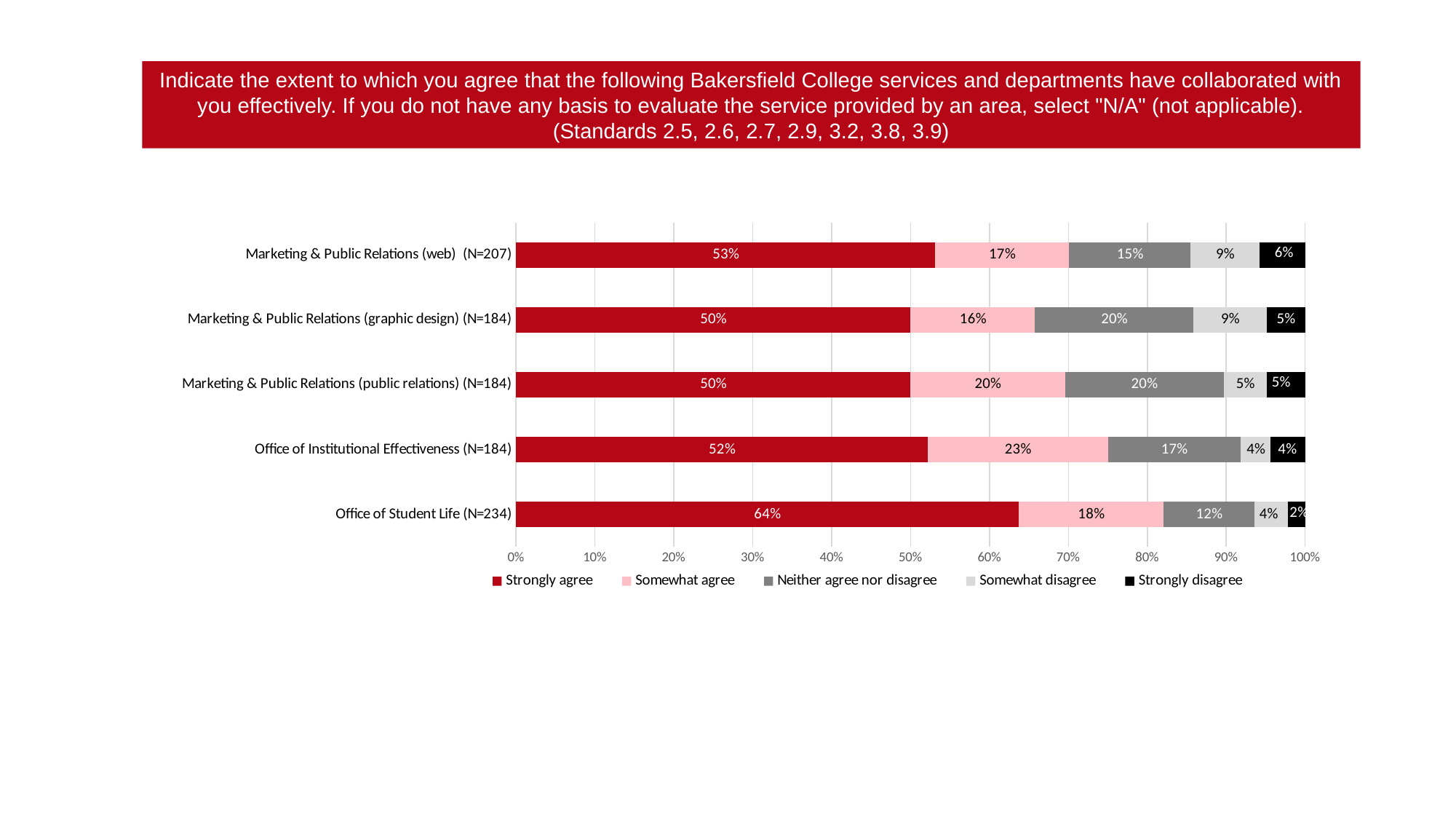
What kind of chart is shown on the slide? Stacked bar chart How many categories (services/departments) are shown on the chart? 5 What is the Strongly disagree value for Marketing & Public Relations (web) (N=207)? 6% How many series does the legend list? 5 Which category has the highest Strongly agree percentage? Office of Student Life (N=234) Which category has the lowest Strongly disagree percentage? Office of Student Life (N=234) Which legend entry is shown in black? Strongly disagree What is the difference between the Strongly agree percentages for Office of Student Life (N=234) and Marketing & Public Relations (web) (N=207)? 11% What percentage of respondents somewhat agree for Office of Institutional Effectiveness (N=184)? 23% Which has a larger Somewhat agree percentage: Marketing & Public Relations (public relations) (N=184) or Marketing & Public Relations (graphic design) (N=184)? Marketing & Public Relations (public relations) (N=184) What percentage of respondents strongly agree for Office of Student Life (N=234)? 64% What is the Neither agree nor disagree value for Marketing & Public Relations (graphic design) (N=184)? 20%